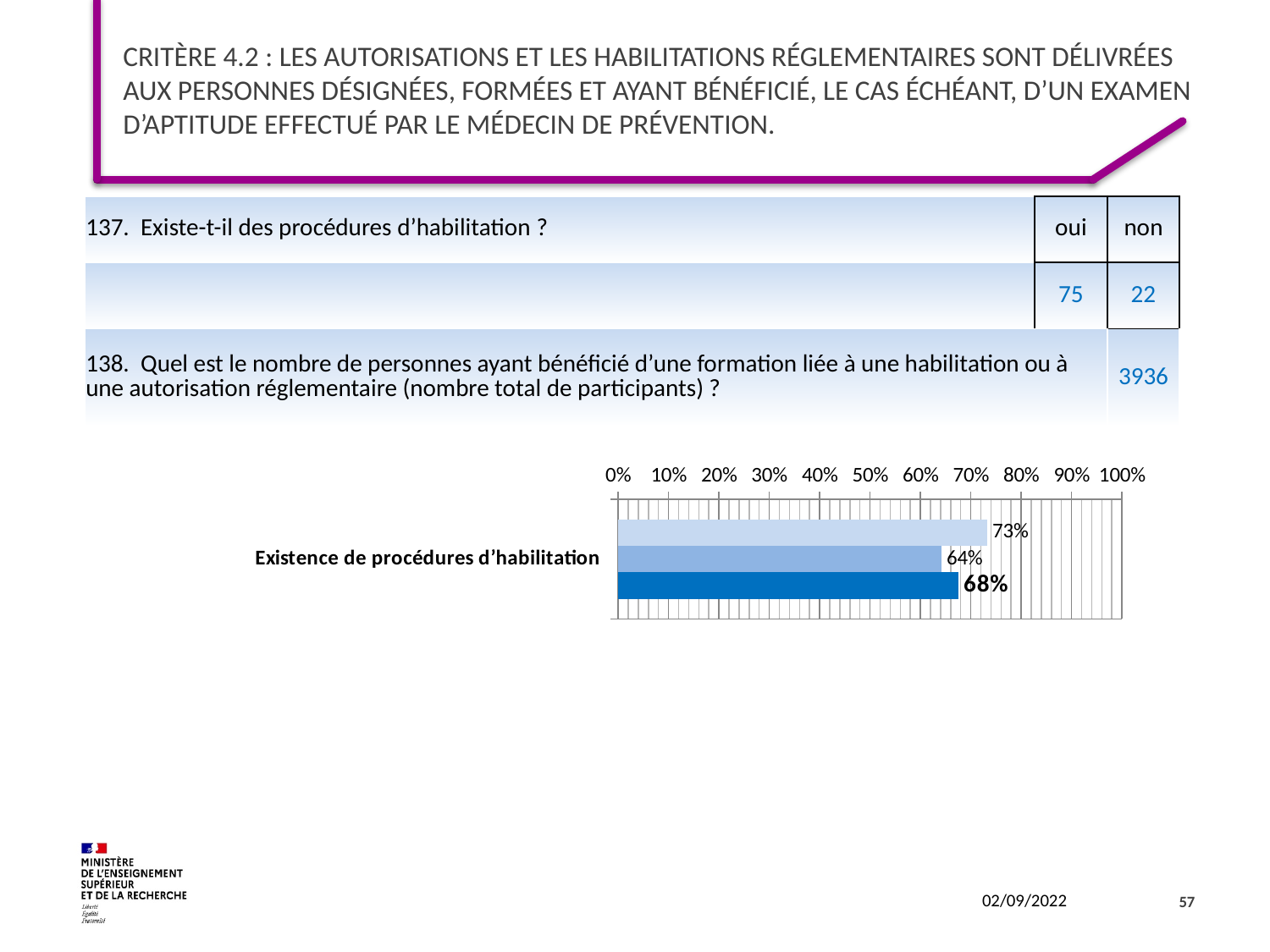
What is the value of the top (lightest blue) bar for "Existence de procédures d'habilitation"? 73% Is the value of the top bar greater or less than 70%? greater What is the difference between the top bar (73%) and the middle bar (64%)? 9 percentage points Which is larger, the value of the bottom bar or the value of the middle bar? the bottom bar (68%) How many categories are shown on the chart's vertical axis? 1 How many bars are plotted for the category "Existence de procédures d'habilitation"? 3 What is the value of the bottom (darkest blue) bar for "Existence de procédures d'habilitation"? 68% Which of the three bars has the highest value? the top bar (73%) Which of the three bars has the lowest value? the middle bar (64%) What is the value of the middle bar for "Existence de procédures d'habilitation"? 64% What is the category label shown on the chart? Existence de procédures d'habilitation What kind of chart is shown on the slide? bar chart